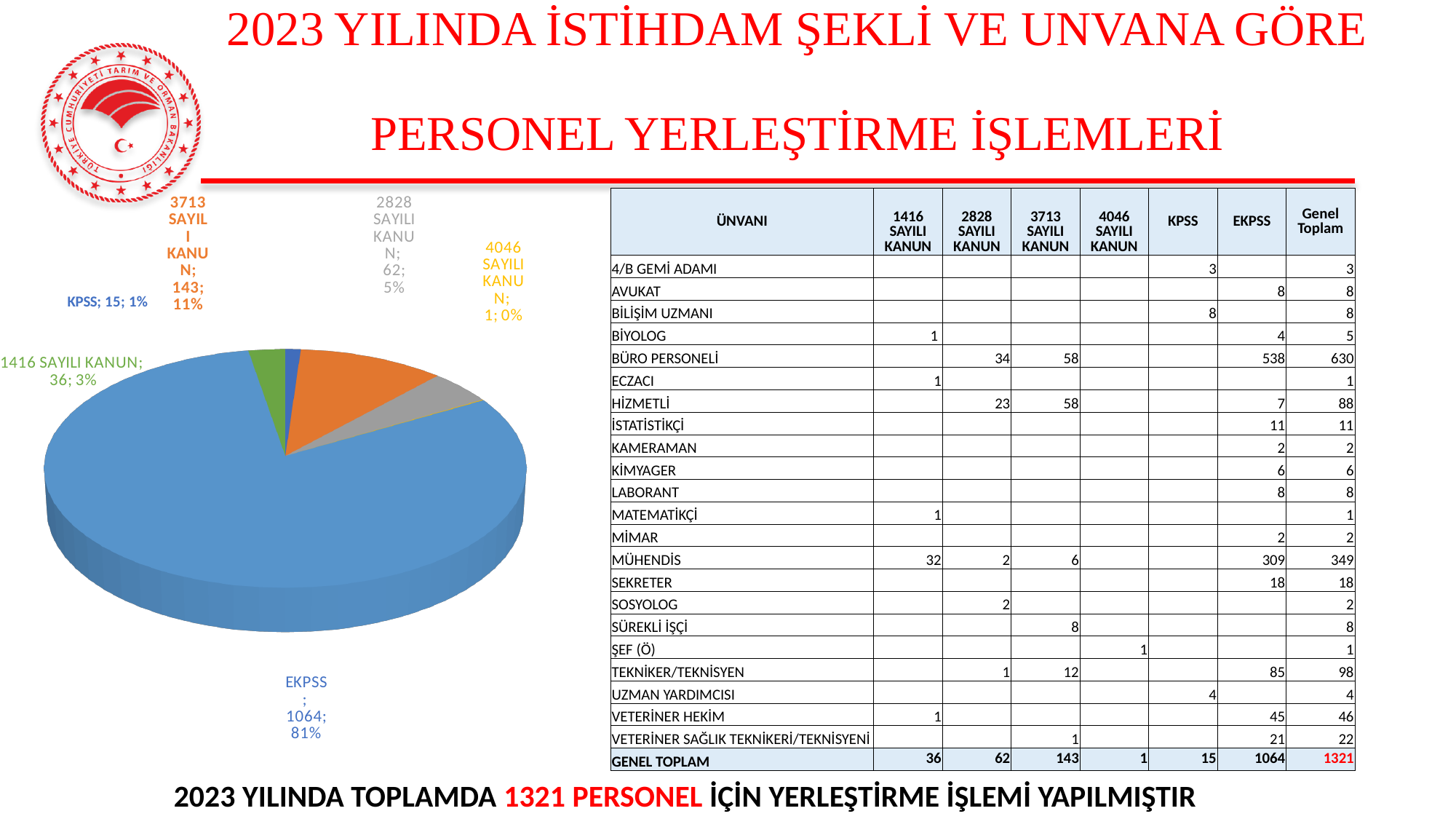
What is the value shown for EKPSS in the pie chart? 1064 What kind of chart is shown on the left of the slide? pie chart Which category has the largest slice in the pie chart? EKPSS What percentage share does EKPSS have in the pie chart? 81% In the pie chart, which is larger: 1416 SAYILI KANUN or 2828 SAYILI KANUN? 2828 SAYILI KANUN What percentage share does 1416 SAYILI KANUN have in the pie chart? 3% What percentage share does 2828 SAYILI KANUN have in the pie chart? 5% Which category has the smallest slice in the pie chart? 4046 SAYILI KANUN What is the difference between the values for 3713 SAYILI KANUN and 2828 SAYILI KANUN in the pie chart? 81 What is the value shown for 3713 SAYILI KANUN in the pie chart? 143 How many slices does the pie chart have? 6 What is the value shown for KPSS in the pie chart? 15